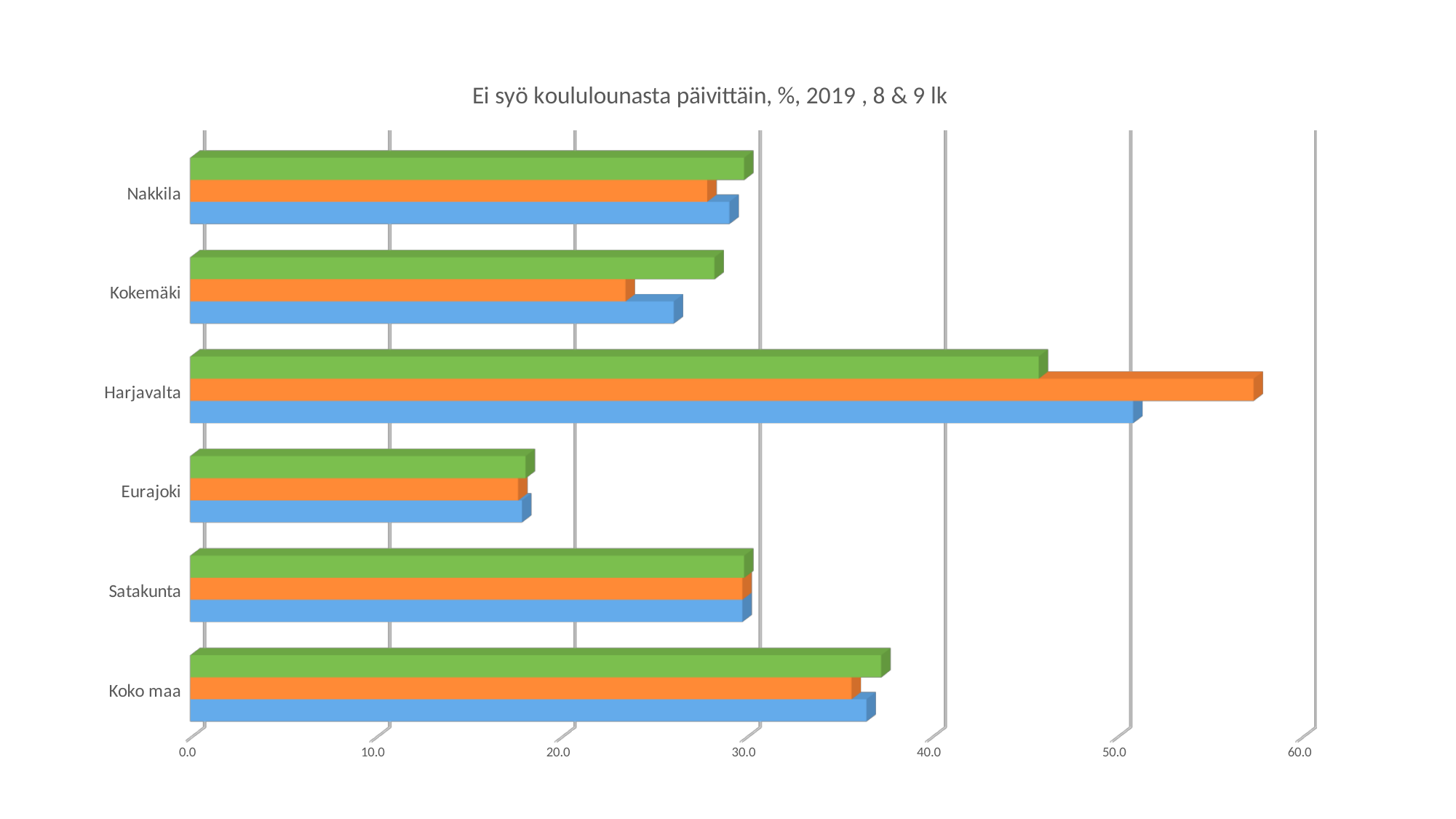
What kind of chart is shown on the slide? bar chart How many categories are shown on the vertical axis of the chart? 6 Which category has the longest orange bar? Harjavalta Is the blue bar for Eurajoki greater or less than 20? less Is the orange bar for Harjavalta greater or less than 50? greater What is the title of the chart? Ei syö koululounasta päivittäin, %, 2019 , 8 & 9 lk Which has the longer blue bar, Nakkila or Kokemäki? Nakkila How many bars are plotted for each category in the chart? 3 Which has the longer orange bar, Harjavalta or Koko maa? Harjavalta Which category has the shortest green bar? Eurajoki Is the green bar for Koko maa greater or less than 30? greater